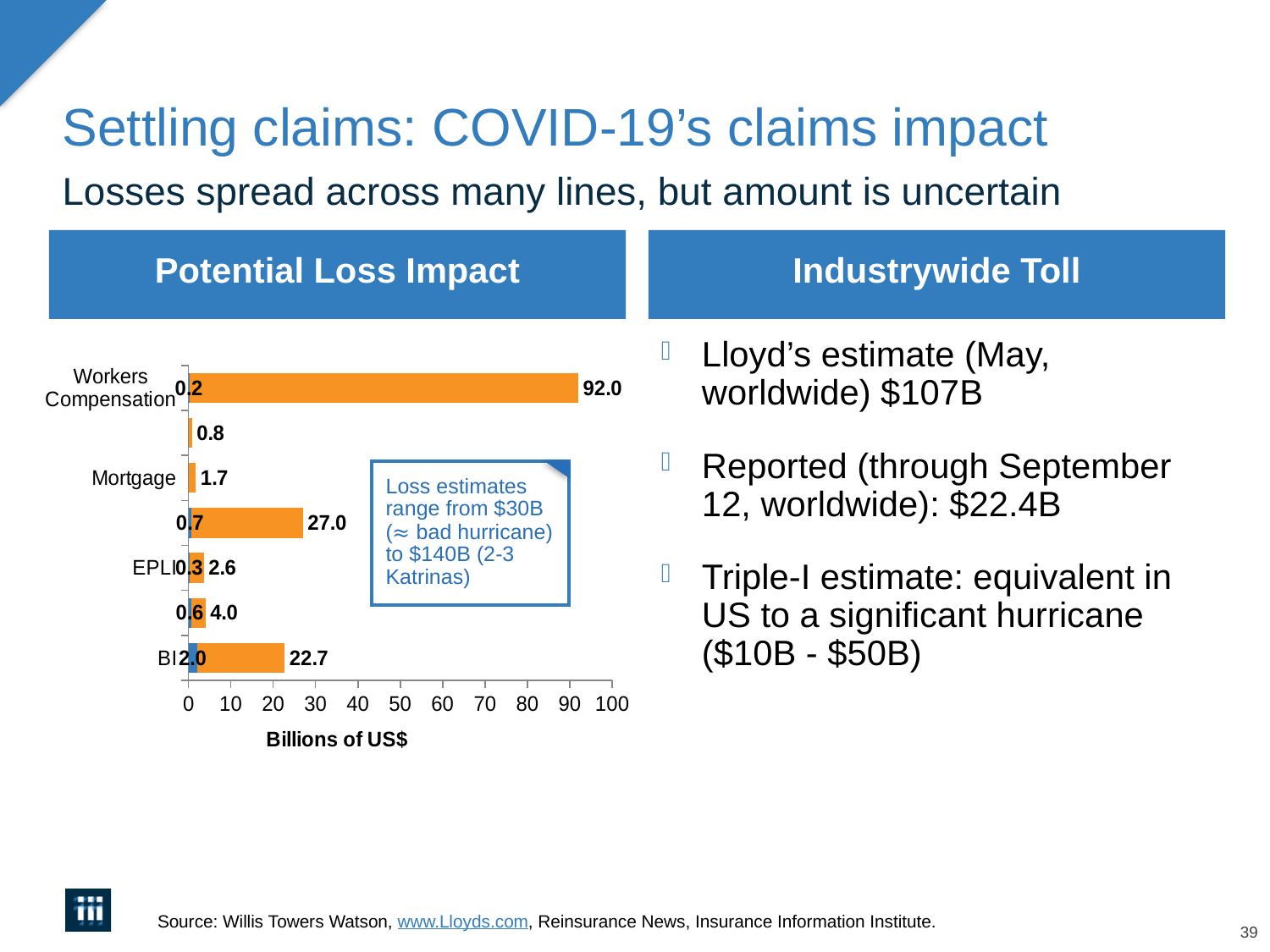
In the Potential Loss Impact chart, what is the value of the orange bar for BI? 22.7 In the Potential Loss Impact chart, what is the value of the orange bar for Workers Compensation? 92.0 What kind of chart is shown under 'Potential Loss Impact'? bar chart In the Potential Loss Impact chart, what is the value of the orange bar for EPLI? 2.6 In the Potential Loss Impact chart, what is the value of the blue bar for BI? 2.0 In the Potential Loss Impact chart, what is the value shown for Mortgage? 1.7 In the Potential Loss Impact chart, what is the difference between the orange and blue bar values for BI? 20.7 In the Potential Loss Impact chart, which category has the longest orange bar? Workers Compensation In the Potential Loss Impact chart, what is the value of the blue bar for Workers Compensation? 0.2 In the Potential Loss Impact chart, what is the difference between the orange bar values for Workers Compensation and BI? 69.3 What is the x-axis title of the Potential Loss Impact chart? Billions of US$ In the Potential Loss Impact chart, which has the larger orange bar value, BI or EPLI? BI